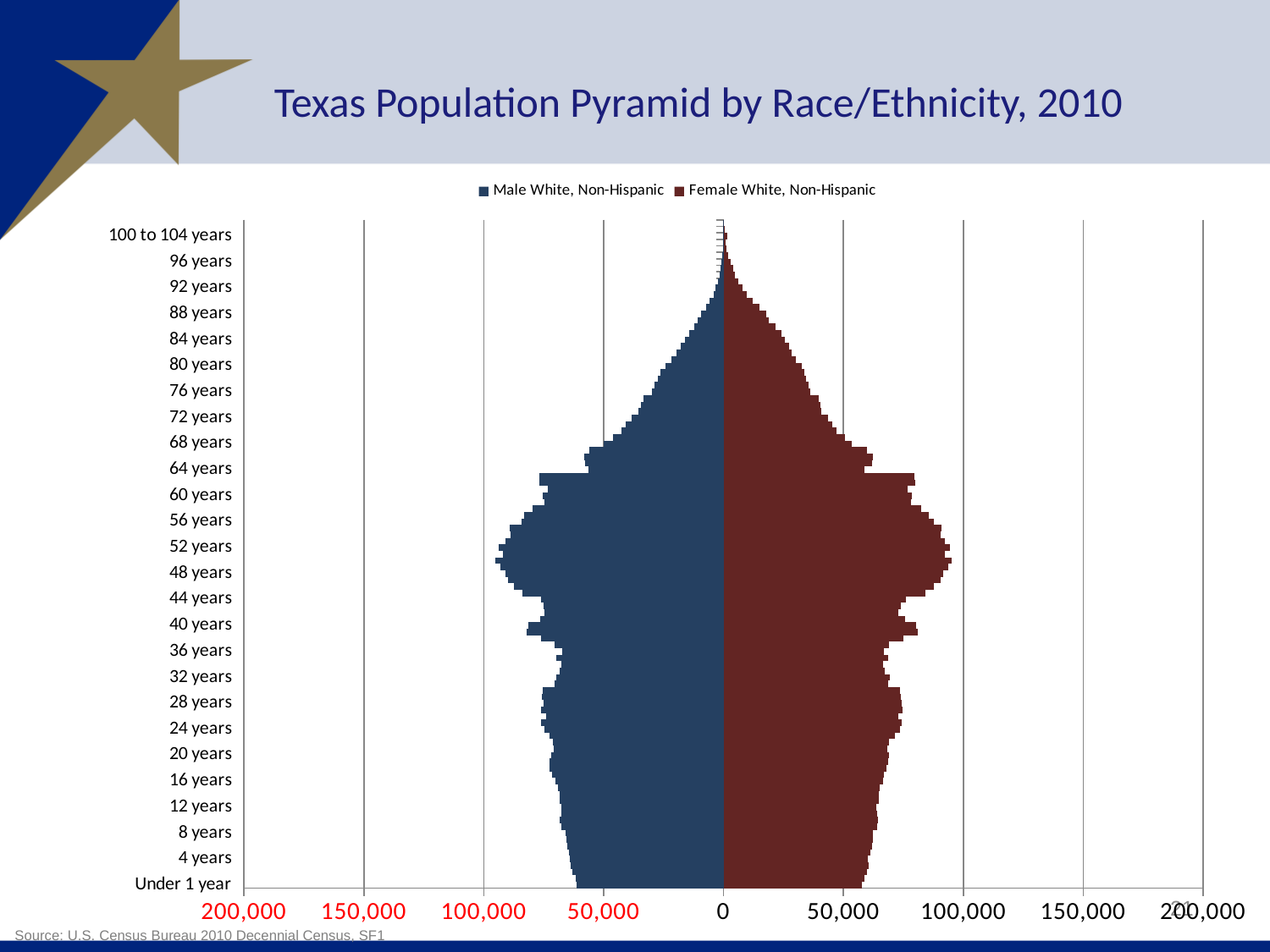
What is the title of the chart? Texas Population Pyramid by Race/Ethnicity, 2010 Is the value for Female White, Non-Hispanic at 88 years greater or less than 50,000? less How many series does the legend list? 2 Is the value for Female White, Non-Hispanic at 52 years greater or less than 50,000? greater Is the value for Male White, Non-Hispanic at 80 years greater or less than 50,000? less Moving from 60 years up to 100 to 104 years, do the Female White, Non-Hispanic bars get longer or shorter? shorter Which is larger for Female White, Non-Hispanic: the value at 52 years or the value at 88 years? 52 years Which series is plotted on the right side of the pyramid? Female White, Non-Hispanic Which is larger for Male White, Non-Hispanic: the value at 52 years or the value at 20 years? 52 years What kind of chart is shown on the slide? Bar chart (population pyramid)